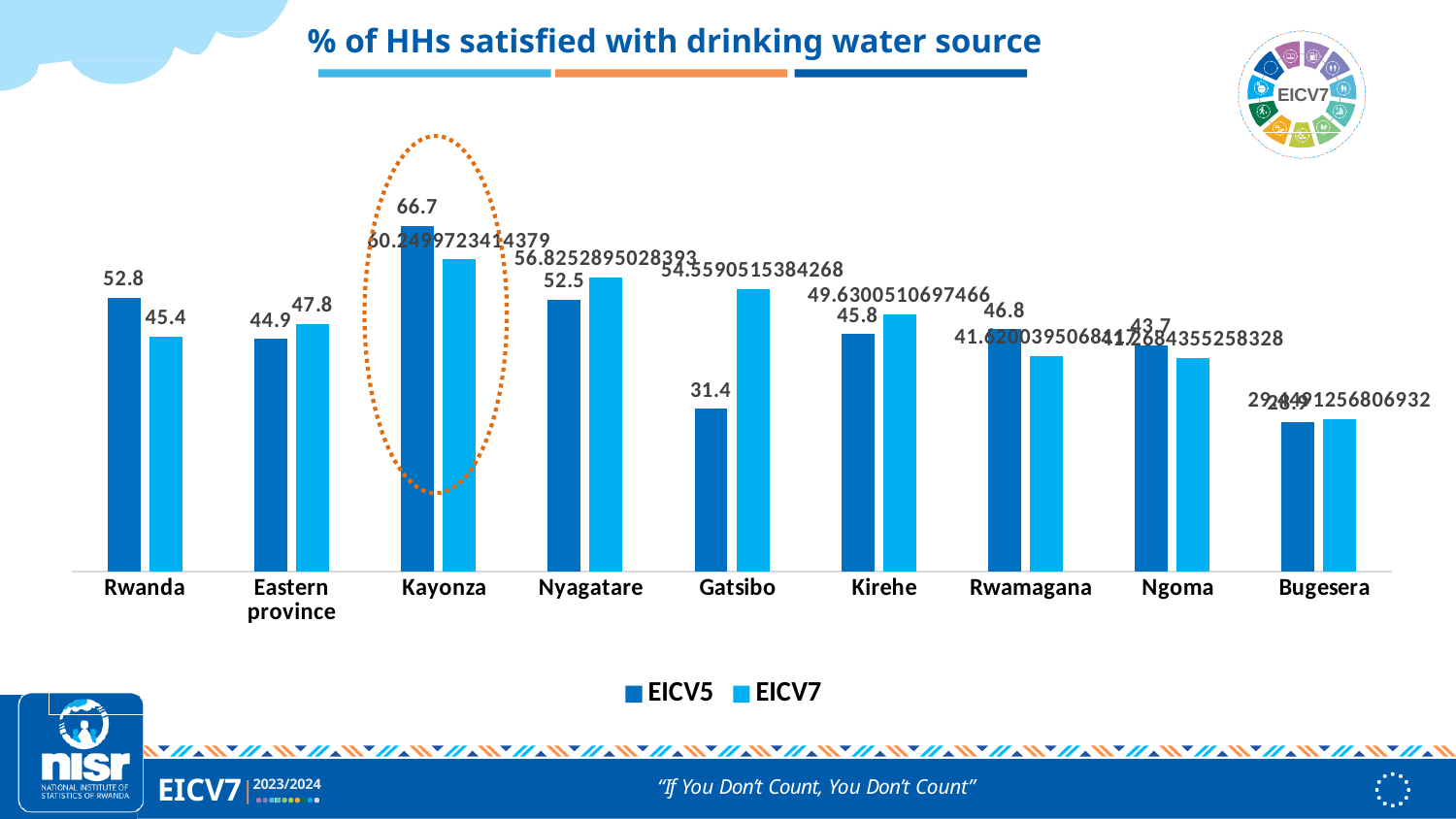
What is the EICV5 value for Gatsibo? 31.4 What is the EICV5 value for Rwanda? 52.8 What type of chart is shown on the slide? bar chart For Gatsibo, which is larger: the EICV5 value or the EICV7 value? EICV7 Which category has the lowest EICV7 value? Bugesera Which category has the highest EICV5 value? Kayonza What is the difference between the EICV5 and EICV7 values for Rwanda? 7.4 How many series does the legend list? 2 What is the EICV7 value for Eastern province? 47.8 What is the title of the chart? % of HHs satisfied with drinking water source Which category is highlighted with a dotted orange circle? Kayonza How many categories are shown along the x axis? 9